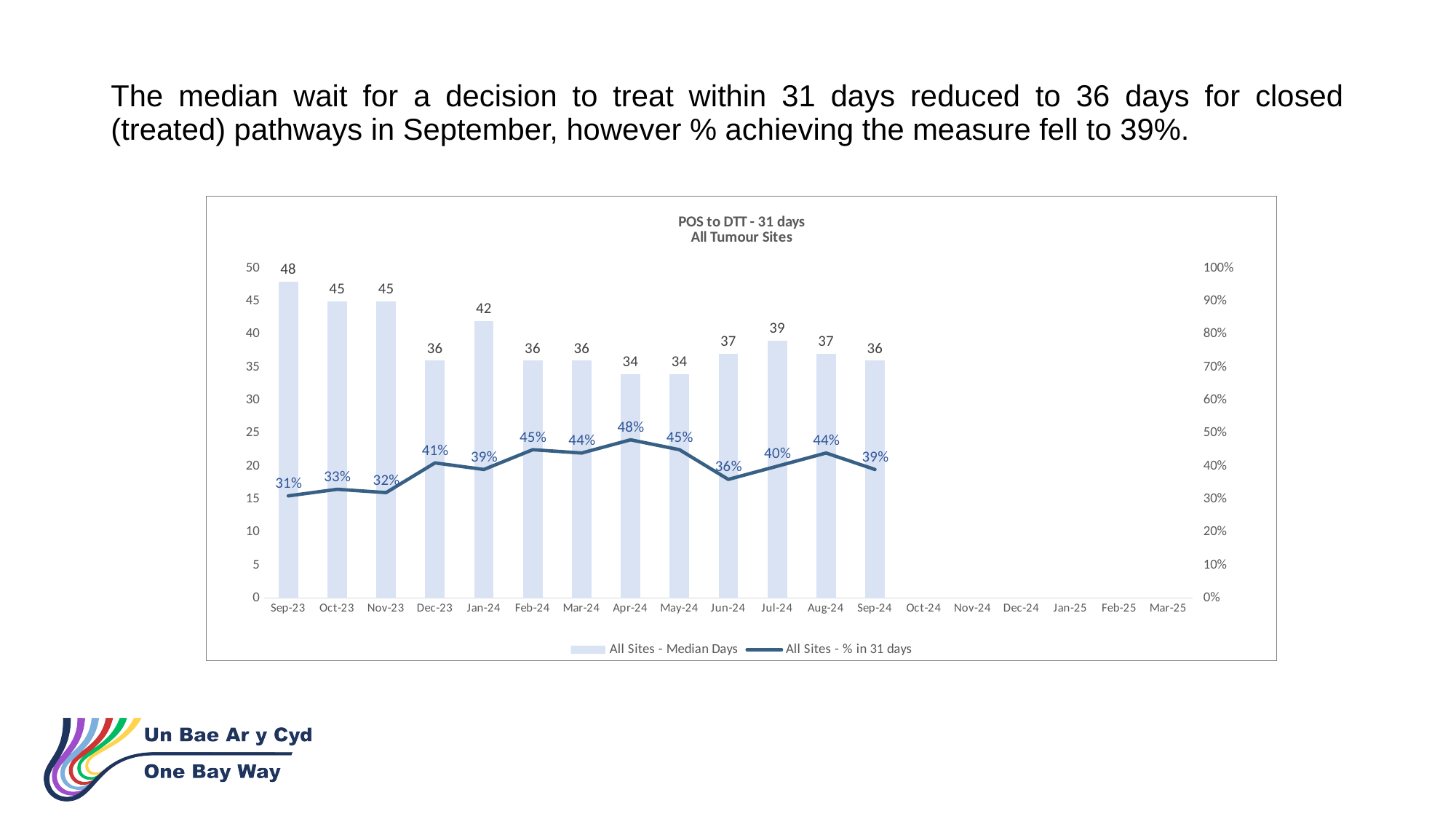
Which is larger, the All Sites - % in 31 days value for Aug-24 or for Sep-24? Aug-24 What is the All Sites - Median Days value for Sep-24? 36 What is the title of the chart? POS to DTT - 31 days All Tumour Sites What is the All Sites - % in 31 days value for Apr-24? 48% What kind of chart is shown on the slide? Combined bar and line chart How many series does the legend list? 2 Which month has the highest All Sites - Median Days value? Sep-23 Does the All Sites - % in 31 days value rise or fall from Sep-23 to Dec-23? Rise How many months have a bar plotted for All Sites - Median Days? 13 What is the value of All Sites - Median Days for Sep-23? 48 Which month has the lowest All Sites - % in 31 days value? Sep-23 What is the difference in All Sites - Median Days between Sep-23 and Sep-24? 12